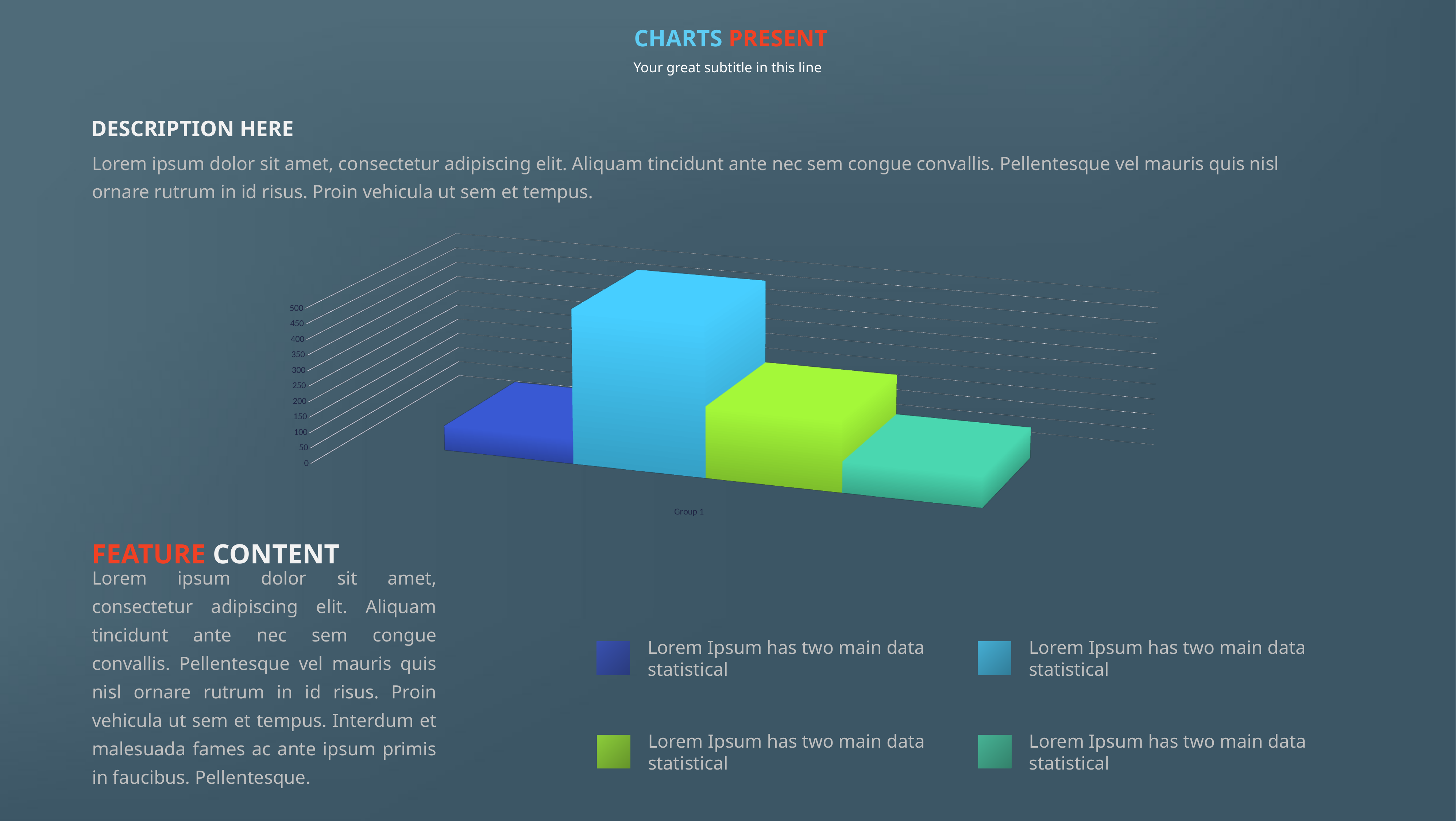
Is the value of the light blue bar greater or less than 250? greater Is the value of the dark blue bar greater or less than 300? less Which is taller, the green bar or the dark blue bar? the green bar How many categories are shown on the chart's horizontal axis? 1 Which bar in the chart is the tallest? the light blue bar Which is taller, the light blue bar or the dark blue bar? the light blue bar What kind of chart is shown on the slide? bar chart What is the highest tick value shown on the chart's vertical axis? 500 Which is taller, the light blue bar or the green bar? the light blue bar How many series does the legend below the chart list? 4 What is the label of the category on the chart's horizontal axis? Group 1